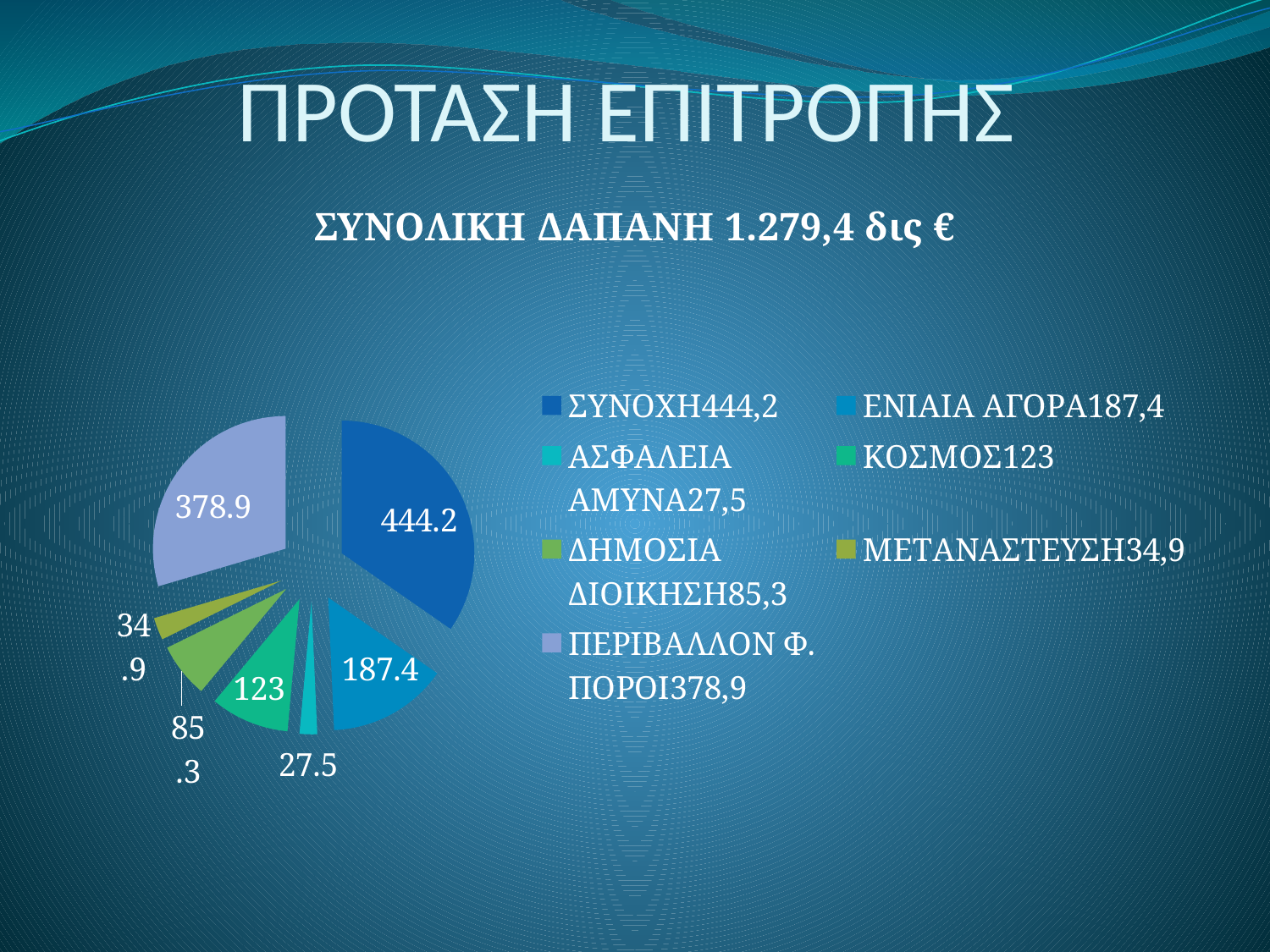
What is the difference between the ΣΥΝΟΧΗ value and the ΠΕΡΙΒΑΛΛΟΝ Φ. ΠΟΡΟΙ value in the pie chart? 65.3 How many slices does the pie chart have? 7 What value is shown for the ΜΕΤΑΝΑΣΤΕΥΣΗ slice of the pie chart? 34.9 What value is shown for the ΣΥΝΟΧΗ slice of the pie chart? 444.2 What total expenditure is stated in the subtitle above the chart? 1.279,4 δις € Which is larger in the pie chart, ΕΝΙΑΙΑ ΑΓΟΡΑ or ΚΟΣΜΟΣ? ΕΝΙΑΙΑ ΑΓΟΡΑ Which category has the largest slice in the pie chart? ΣΥΝΟΧΗ What value is shown for the ΚΟΣΜΟΣ slice of the pie chart? 123 What is the difference between the ΔΗΜΟΣΙΑ ΔΙΟΙΚΗΣΗ value and the ΜΕΤΑΝΑΣΤΕΥΣΗ value in the pie chart? 50.4 What kind of chart is shown on the slide? Pie chart What value is shown for the ΠΕΡΙΒΑΛΛΟΝ Φ. ΠΟΡΟΙ slice of the pie chart? 378.9 Which category has the smallest slice in the pie chart? ΑΣΦΑΛΕΙΑ ΑΜΥΝΑ